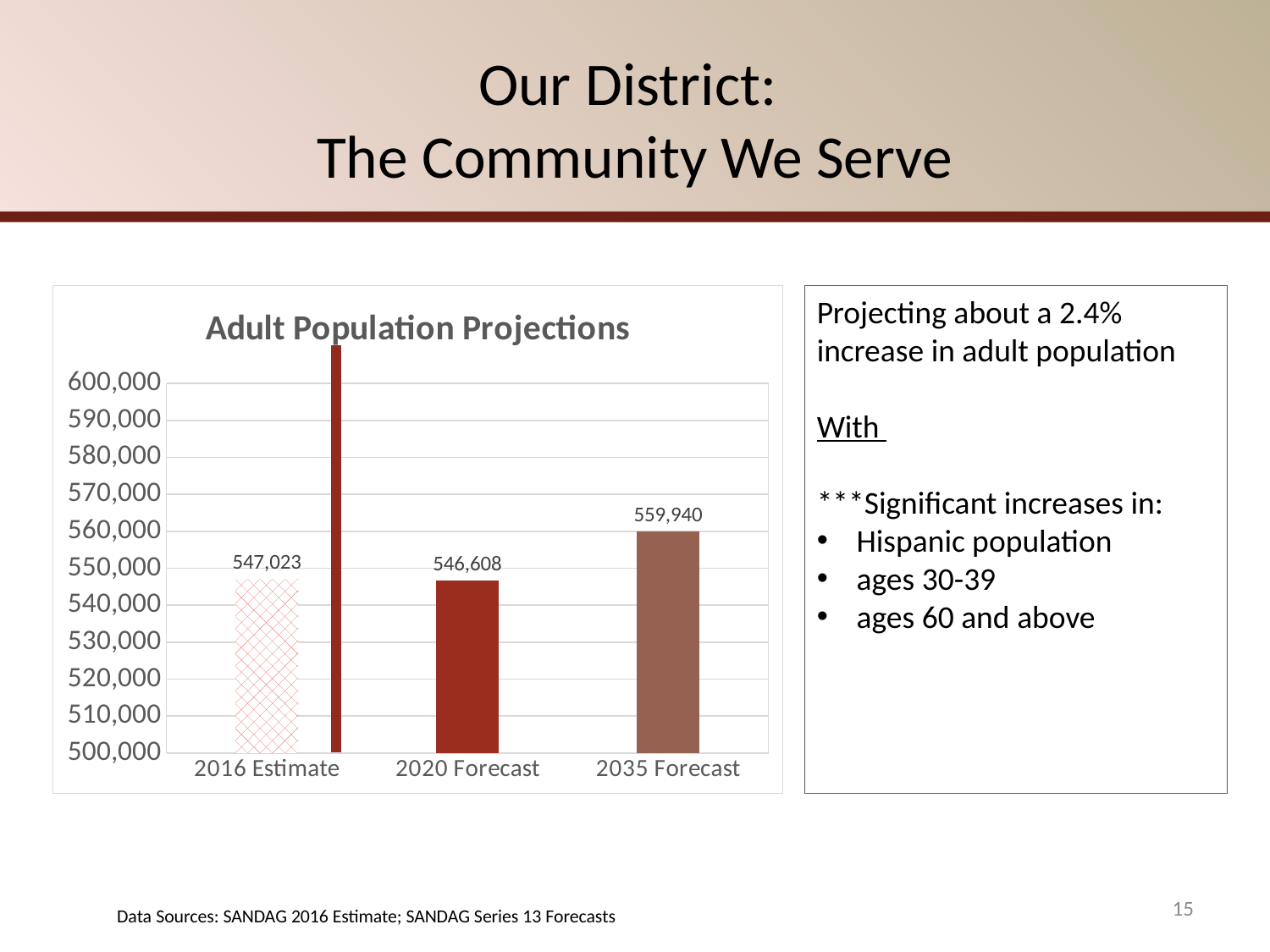
What is the value for 2020 Forecast in the Adult Population Projections chart? 546,608 What is the difference between the 2035 Forecast and the 2020 Forecast values? 13,332 How many categories are shown on the x axis of the Adult Population Projections chart? 3 What is the value for 2035 Forecast in the Adult Population Projections chart? 559,940 What kind of chart is the Adult Population Projections chart? bar chart Is the value for 2035 Forecast greater or less than 550,000? greater Which is larger, the value for 2016 Estimate or the value for 2020 Forecast? 2016 Estimate Which category has the lowest value in the Adult Population Projections chart? 2020 Forecast What is the value for 2016 Estimate in the Adult Population Projections chart? 547,023 Which category has the highest value in the Adult Population Projections chart? 2035 Forecast Does the value rise or fall from 2020 Forecast to 2035 Forecast? rise What is the difference between the 2016 Estimate and the 2020 Forecast values? 415